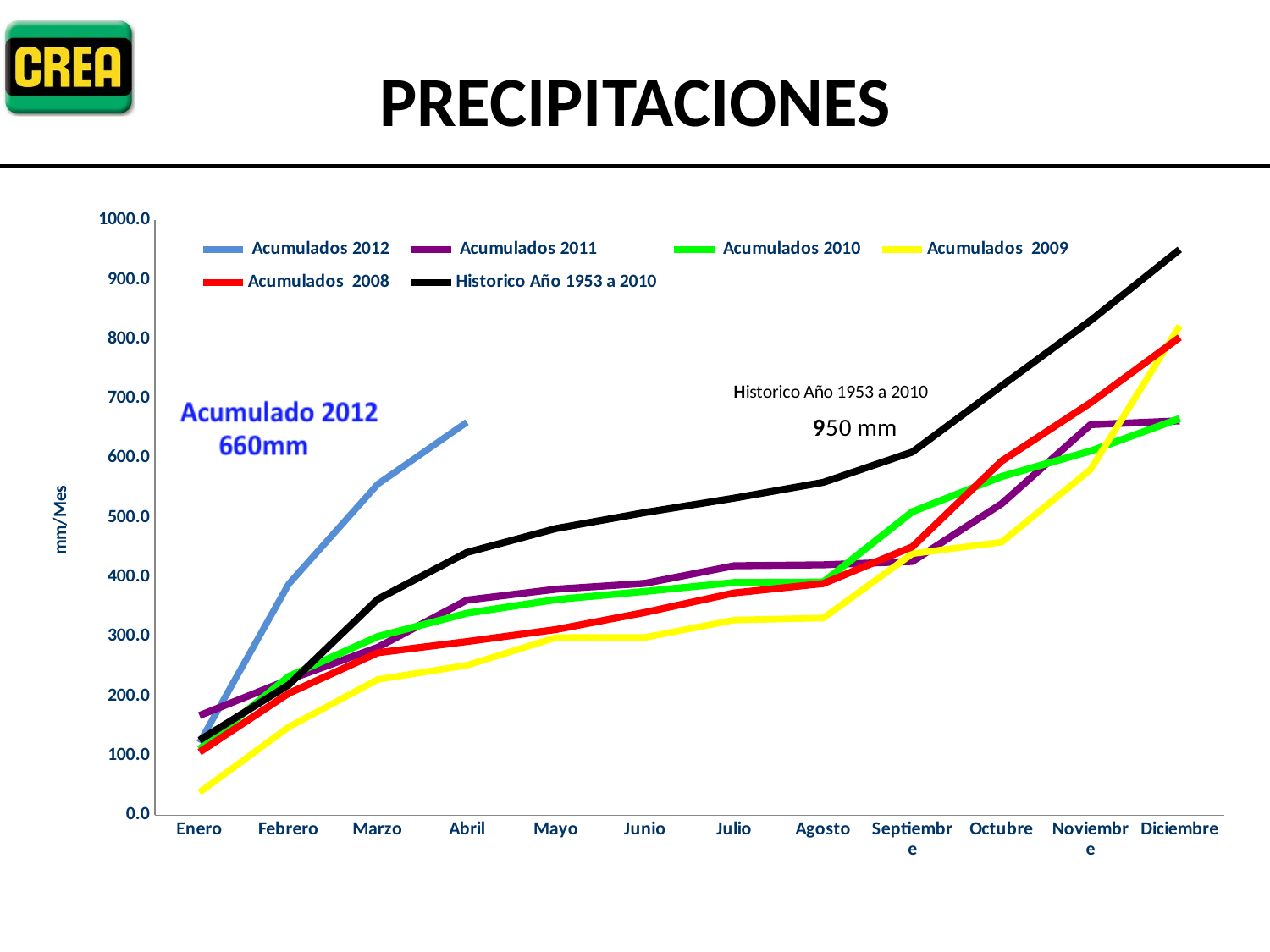
Is the value for Acumulados 2010 in Septiembre greater or less than 400? greater Is the value for Acumulados 2009 in Enero greater or less than 100? less What accumulated value does the slide annotation give for Acumulado 2012? 660mm What type of chart is shown on the slide? line chart How many series does the legend list? 6 What value does the slide annotation give for Historico Año 1953 a 2010? 950 mm Is the value for Historico Año 1953 a 2010 in Diciembre greater or less than 900? greater In Diciembre, which is larger: Acumulados 2009 or Acumulados 2011? Acumulados 2009 Which series has the lowest value in Enero? Acumulados 2009 Which series has the highest value in Diciembre? Historico Año 1953 a 2010 How many months are shown along the x axis? 12 In Abril, which is larger: Acumulados 2012 or Historico Año 1953 a 2010? Acumulados 2012